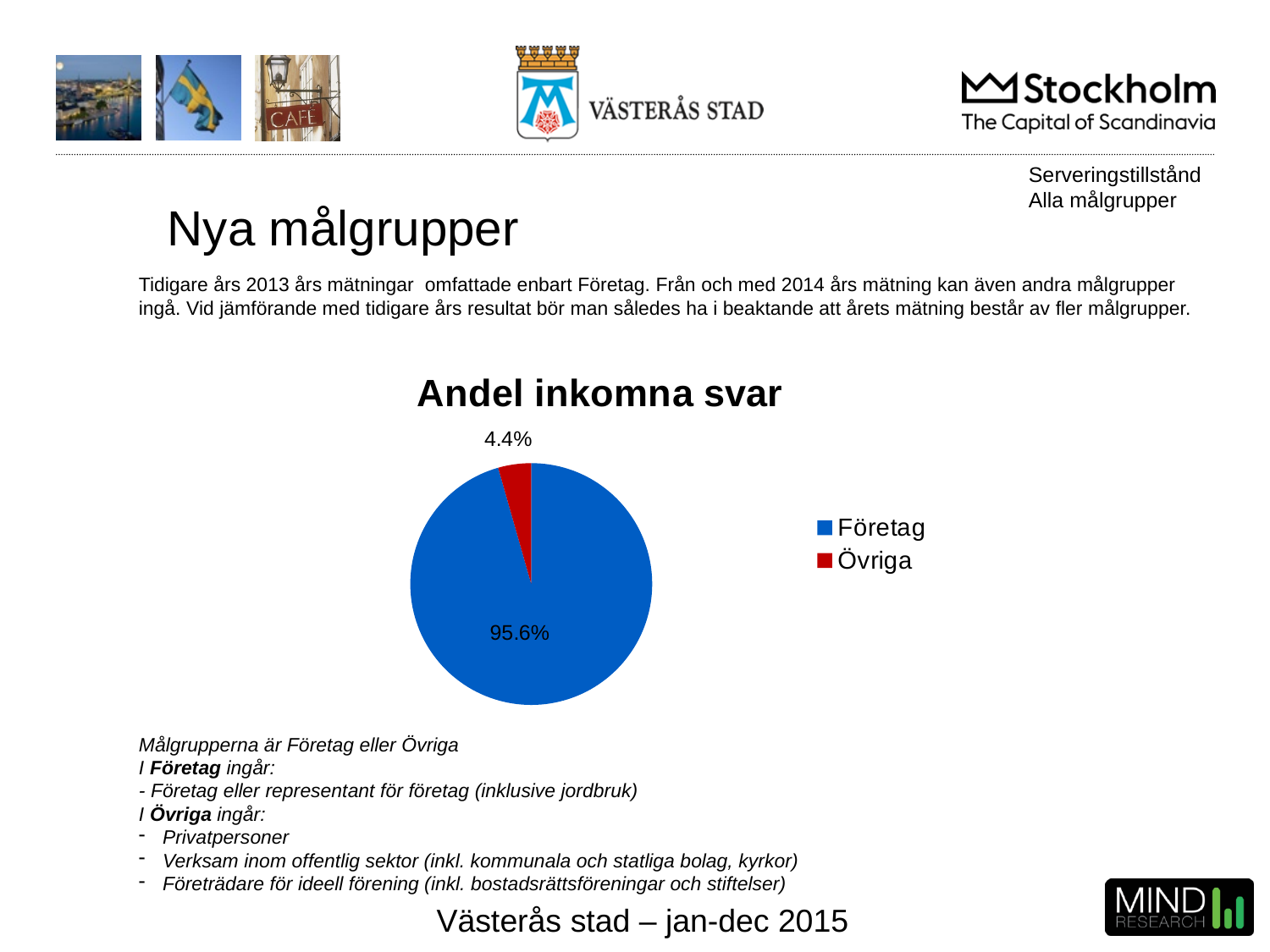
Which is larger, the share for Företag or the share for Övriga? Företag What is the difference in percentage points between the Företag and Övriga slices? 91.2 Is the share for Övriga greater or less than 10%? less What colour is the Övriga slice in the pie chart? Red How many categories does the pie chart show? 2 Which category has the smallest slice in the pie chart? Övriga What is the share for Företag in the pie chart? 95.6% What is the title of the chart? Andel inkomna svar Which category has the largest slice in the pie chart? Företag How many entries does the legend list? 2 What is the share for Övriga in the pie chart? 4.4% What kind of chart is shown on the slide? Pie chart